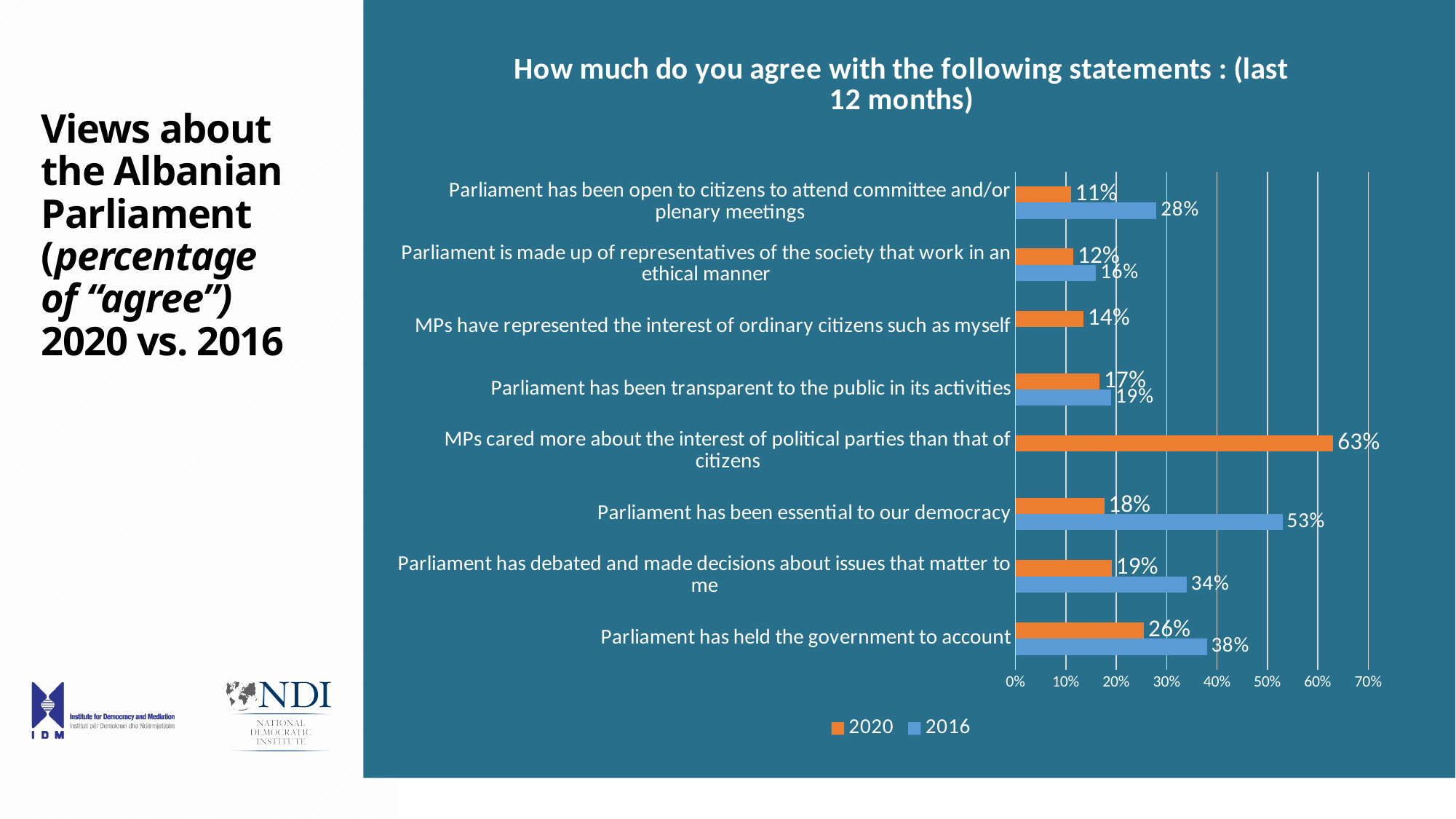
What is the 2020 value for "Parliament has held the government to account"? 26% How many series does the legend list? 2 Which is larger for "Parliament has debated and made decisions about issues that matter to me": the 2020 value or the 2016 value? 2016 What is the 2016 value for "Parliament has been essential to our democracy"? 53% Which statement has the lowest 2020 value? Parliament has been open to citizens to attend committee and/or plenary meetings How many statements are shown on the chart? 8 Which statement has the highest 2016 value? Parliament has been essential to our democracy Which statement has the highest 2020 value? MPs cared more about the interest of political parties than that of citizens Is the 2016 value for "Parliament has held the government to account" greater or less than 30%? greater What is the difference between the 2016 and 2020 values for "Parliament has been essential to our democracy"? 35% What kind of chart is shown on the slide? Bar chart What is the 2020 value for "MPs cared more about the interest of political parties than that of citizens"? 63%